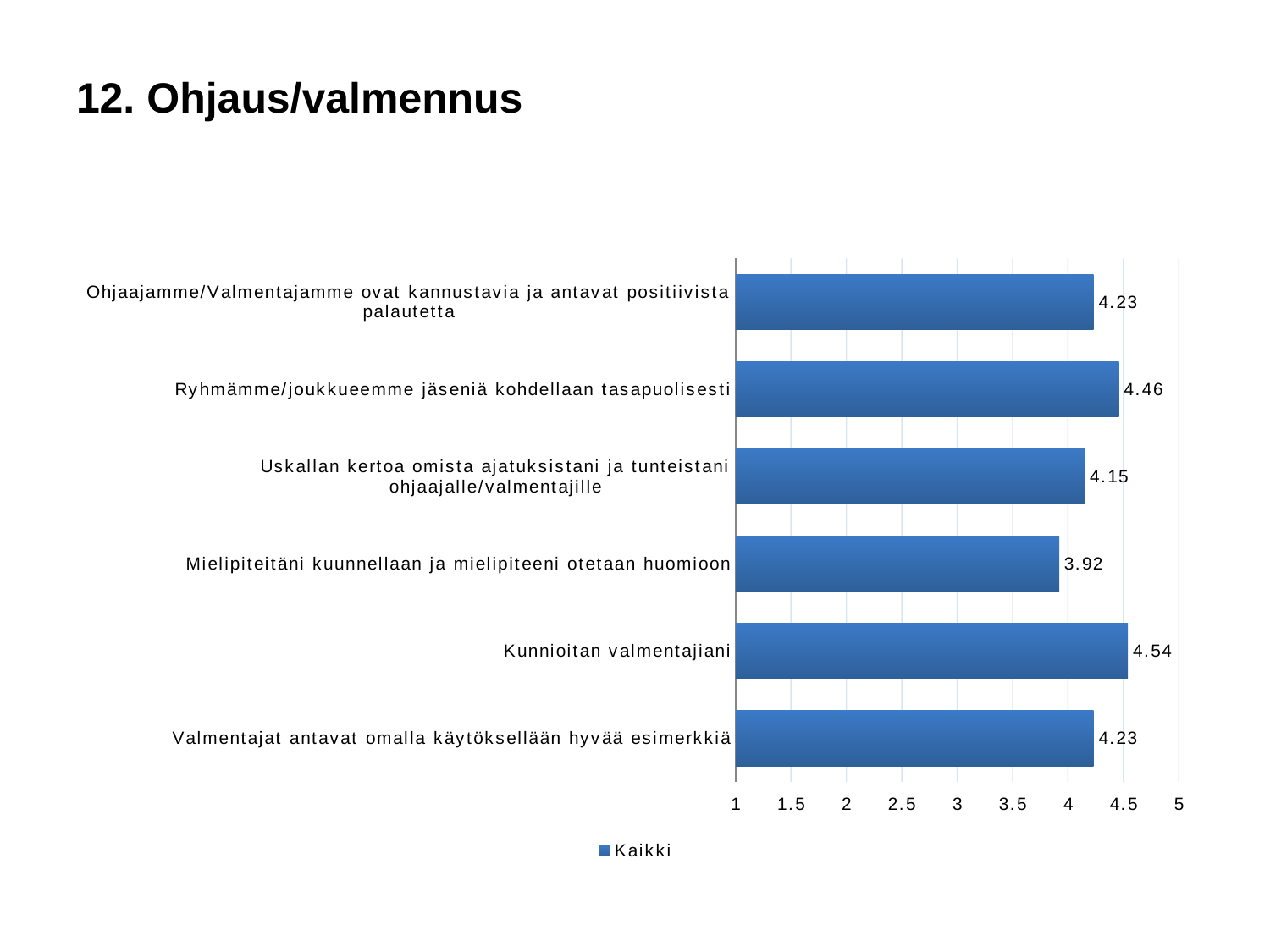
What is the value for "Uskallan kertoa omista ajatuksistani ja tunteistani ohjaajalle/valmentajille"? 4.15 Which category has the highest value? Kunnioitan valmentajiani Is the value for "Mielipiteitäni kuunnellaan ja mielipiteeni otetaan huomioon" greater or less than 4? less What is the value for "Ryhmämme/joukkueemme jäseniä kohdellaan tasapuolisesti"? 4.46 How many categories are shown in the chart? 6 What is the value for "Kunnioitan valmentajiani"? 4.54 What is the value for "Mielipiteitäni kuunnellaan ja mielipiteeni otetaan huomioon"? 3.92 Which is larger: the value for "Ryhmämme/joukkueemme jäseniä kohdellaan tasapuolisesti" or the value for "Uskallan kertoa omista ajatuksistani ja tunteistani ohjaajalle/valmentajille"? Ryhmämme/joukkueemme jäseniä kohdellaan tasapuolisesti What kind of chart is shown on the slide? Bar chart Which category has the lowest value? Mielipiteitäni kuunnellaan ja mielipiteeni otetaan huomioon What is the difference between the values for "Kunnioitan valmentajiani" and "Mielipiteitäni kuunnellaan ja mielipiteeni otetaan huomioon"? 0.62 How many series does the legend list? 1